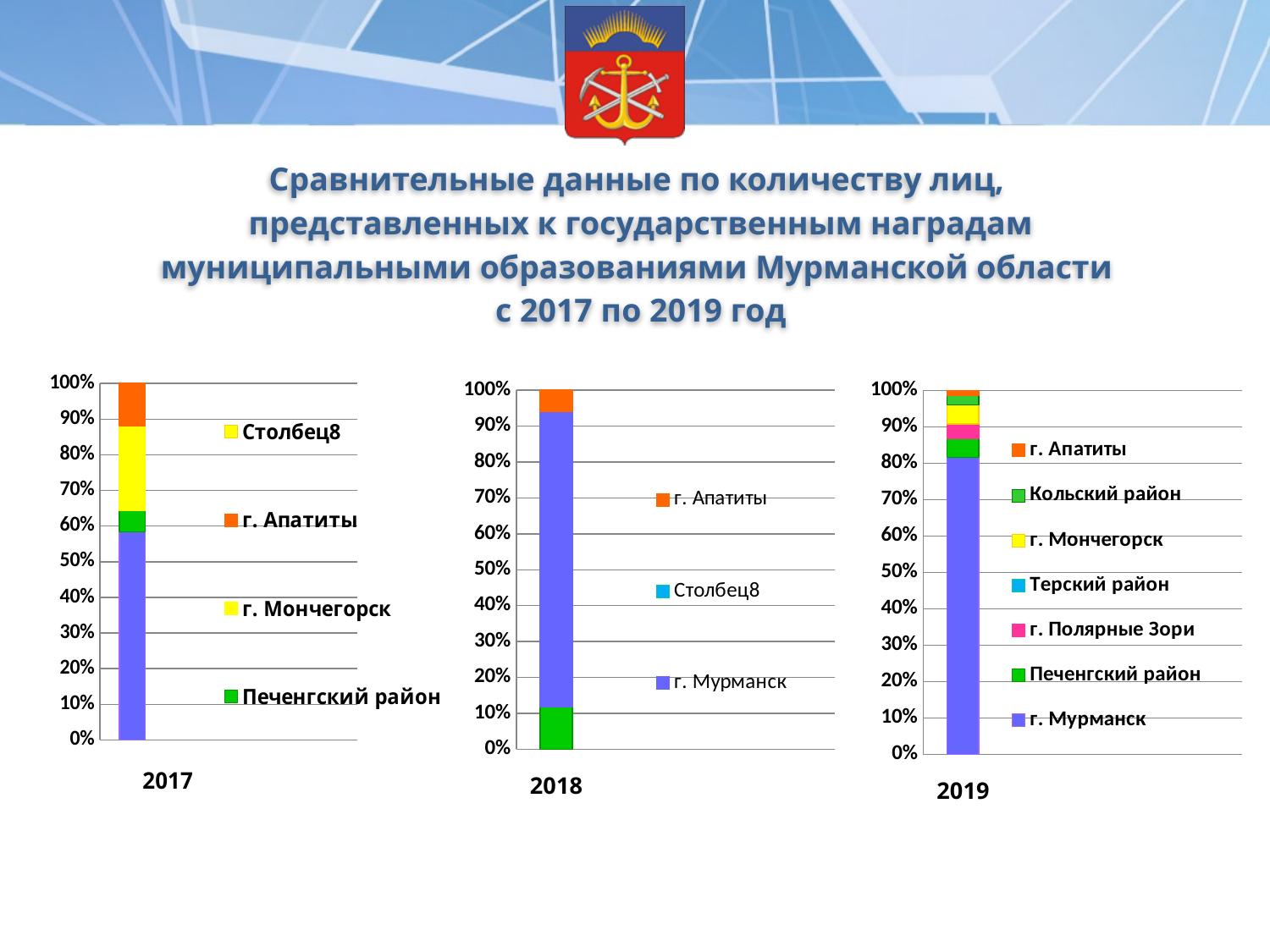
How many entries does the legend of the 2019 chart list? 7 In the 2019 chart, what colour represents г. Апатиты in the legend? orange In the 2018 chart, is the share for г. Апатиты greater or less than 10%? less In the 2017 chart, which is larger, the share for г. Мончегорск or the share for Печенгский район? г. Мончегорск What kind of chart is shown for 2017? stacked bar chart In the 2017 chart, which is larger, the share for г. Мончегорск or the share for г. Апатиты? г. Мончегорск In the 2019 chart, which is larger, the share for г. Мурманск or the share for г. Апатиты? г. Мурманск In the 2019 chart, is the share for г. Мурманск greater or less than 70%? greater How many entries does the legend of the 2018 chart list? 3 Which year's chart has the most legend entries? 2019 How many separate charts are shown on the slide? 3 How many entries does the legend of the 2017 chart list? 4